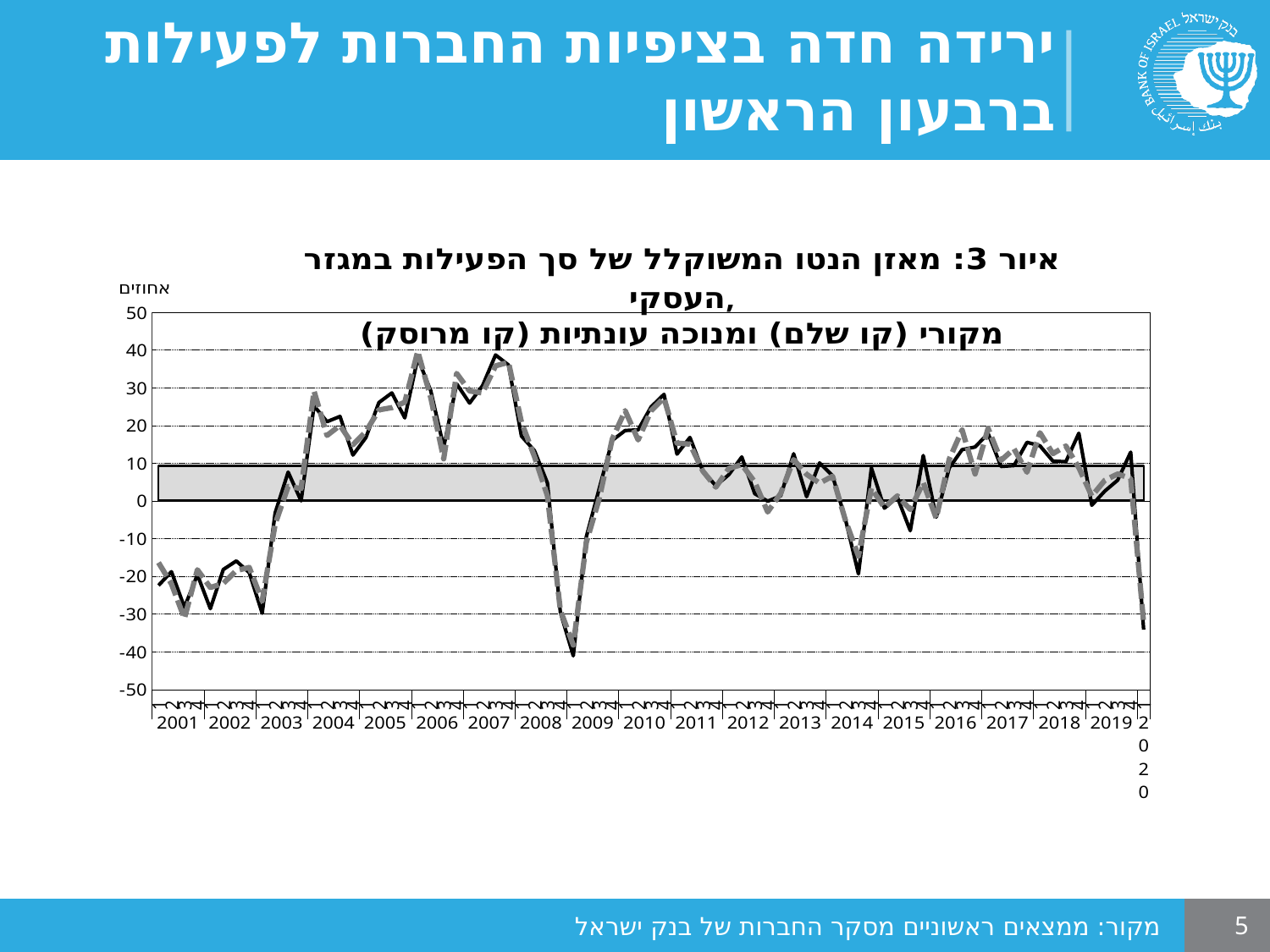
Is the value of the solid line at the start of 2001 greater or less than 0? less What is the highest value shown on the vertical axis? 50 Is the final value of the solid line in 2020 greater or less than -20? less What kind of chart is shown on the slide? line chart What unit label appears above the vertical axis? אחוזים How many years are labelled along the horizontal axis? 20 How many line series are plotted on the chart? 2 Is the peak value of the solid line in 2007 greater or less than 30? greater Do the values rise or fall between the end of 2019 and the last point in 2020? fall Do the values rise or fall between 2001 and the end of 2003? rise